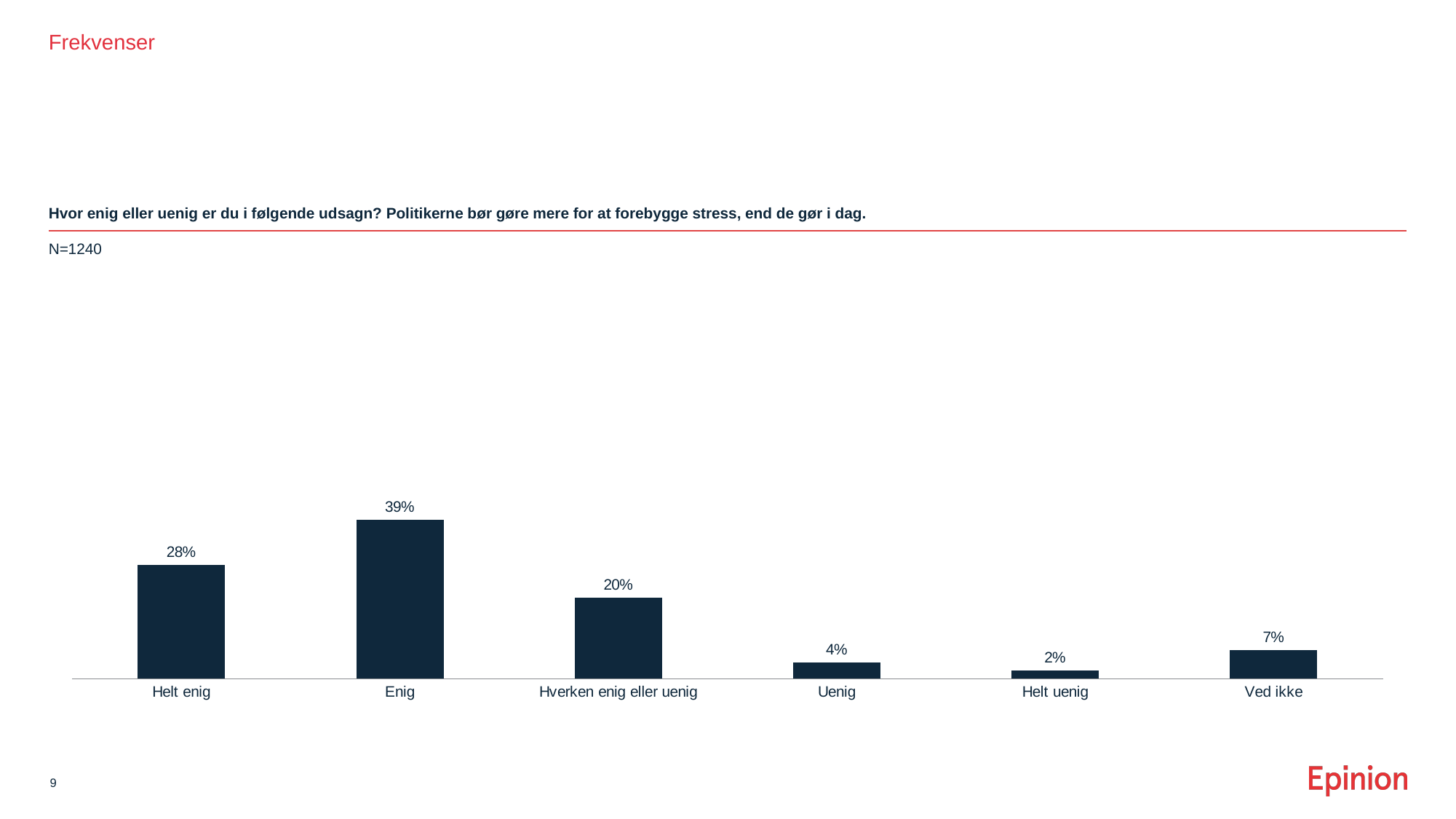
What is the difference between the values for "Ved ikke" and "Uenig"? 3% What is the difference between the values for "Enig" and "Helt enig"? 11% Which category has the lowest value? Helt uenig What percentage of respondents answered "Helt enig"? 28% What percentage is shown for "Hverken enig eller uenig"? 20% What is the sample size (N) stated on the slide? N=1240 What is the value shown for "Enig"? 39% Which is larger, the value for "Uenig" or the value for "Ved ikke"? Ved ikke What is the value for "Ved ikke"? 7% Which category has the highest value? Enig How many categories are shown on the x axis? 6 What kind of chart is shown on the slide? Bar chart